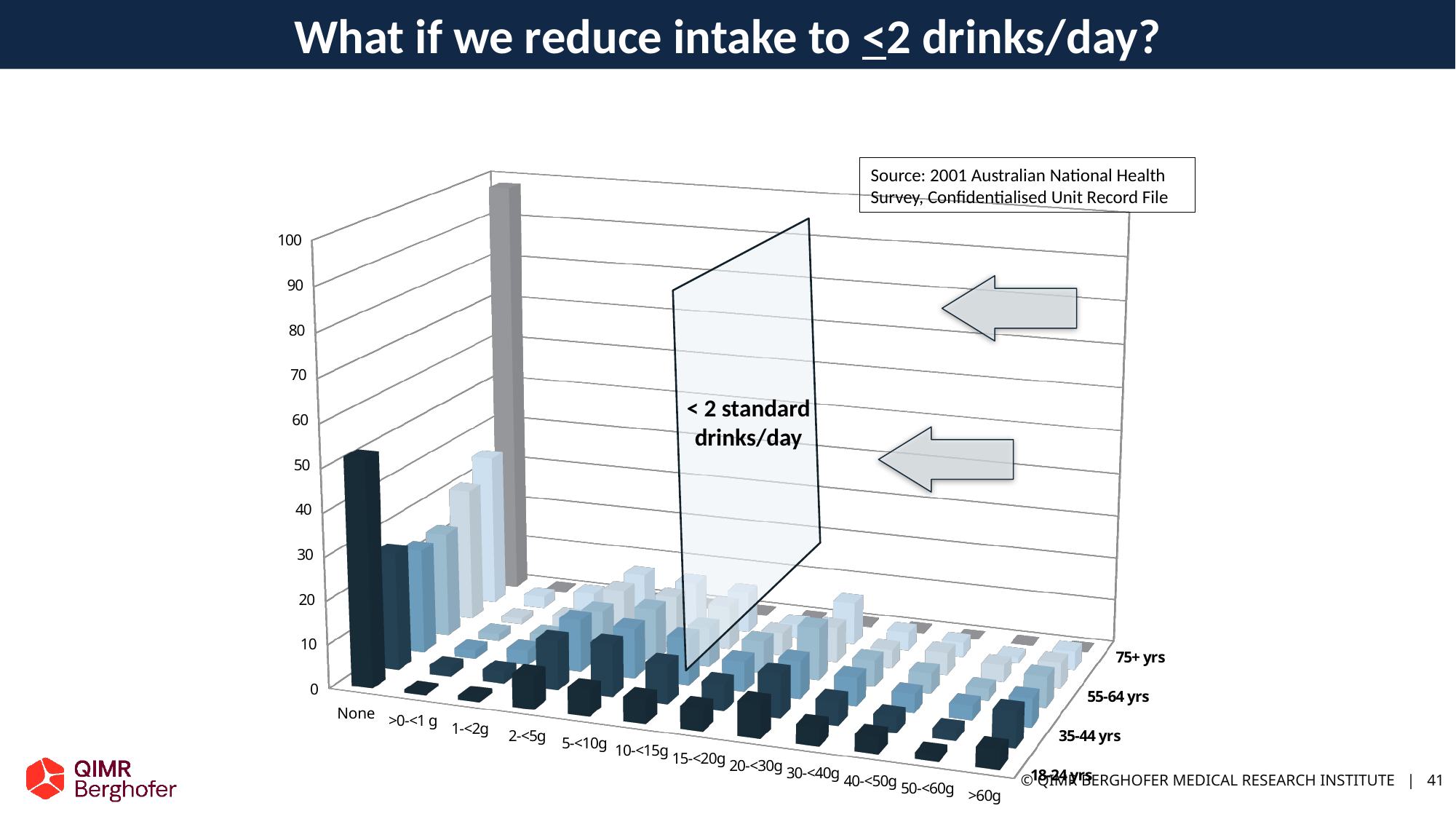
For the 18-24 yrs group, is the value for >0-<1 g greater or less than 10? less What is the highest value shown on the vertical axis? 100 For the 18-24 yrs group, which is larger: the value for None or the value for >0-<1 g? None What is the last category on the x axis? >60g For the 18-24 yrs group, which intake category has the highest bar? None For the 18-24 yrs group, is the value for None greater or less than 30? greater What kind of chart is shown on the slide? bar chart What is the first category on the x axis? None For the 18-24 yrs group, is the value for >60g greater or less than 30? less How many alcohol intake categories are shown along the x axis? 12